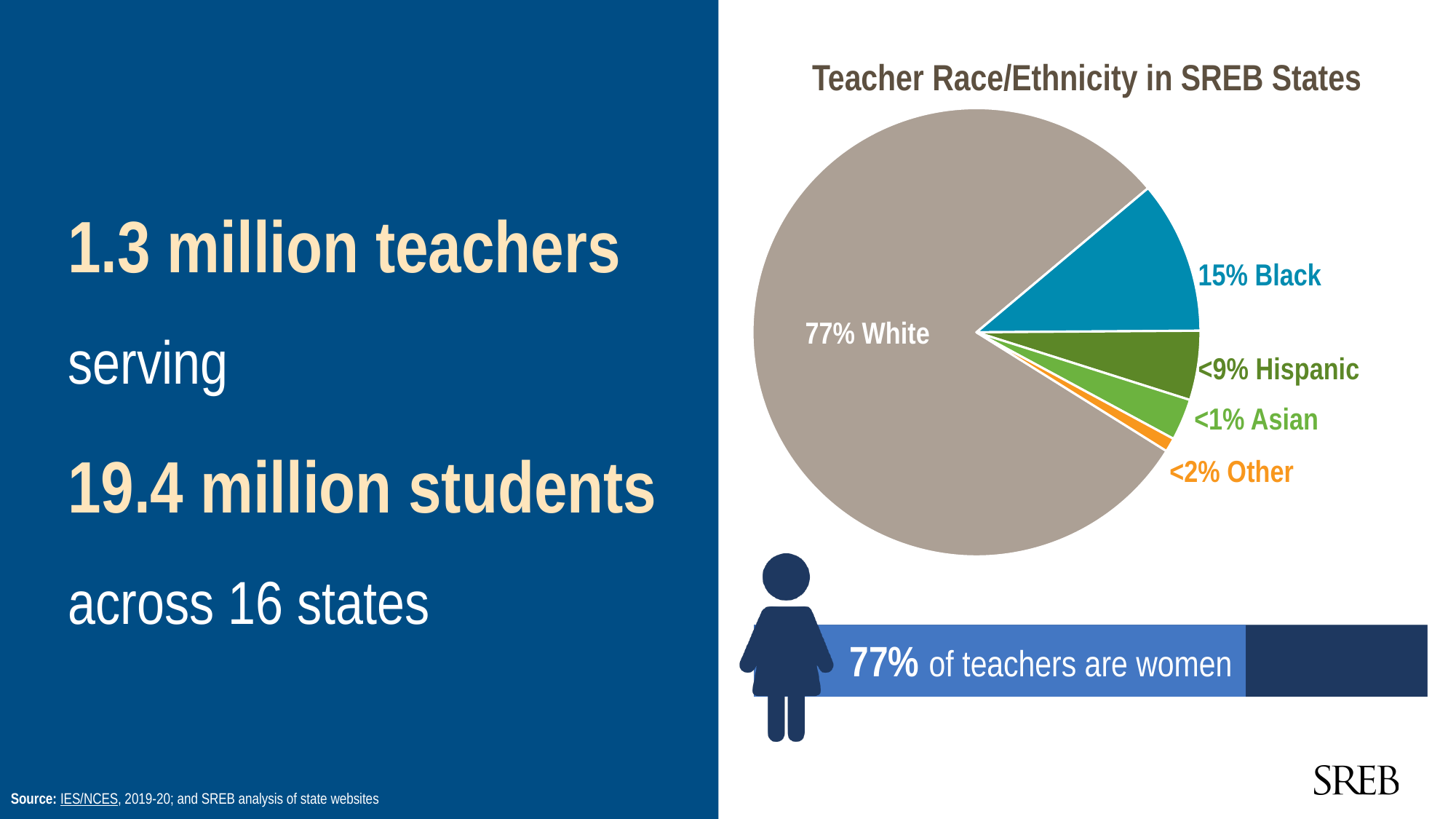
What label is shown for the Other slice of the pie chart? <2% Other What is the difference in percentage points between the White and Black slices of the pie chart? 62 percentage points What label is shown for the Asian slice of the pie chart? <1% Asian Which race/ethnicity group has the largest slice in the pie chart? White What is the title of the pie chart? Teacher Race/Ethnicity in SREB States In the pie chart, what percentage of teachers in SREB states are White? 77% In the pie chart, which slice is larger: Black or Hispanic? Black How many slices does the pie chart have? 5 What type of chart is shown under the title "Teacher Race/Ethnicity in SREB States"? Pie chart What colour is the Black slice in the pie chart? Teal blue What label is shown for the Hispanic slice of the pie chart? <9% Hispanic In the pie chart, what percentage of teachers in SREB states are Black? 15%